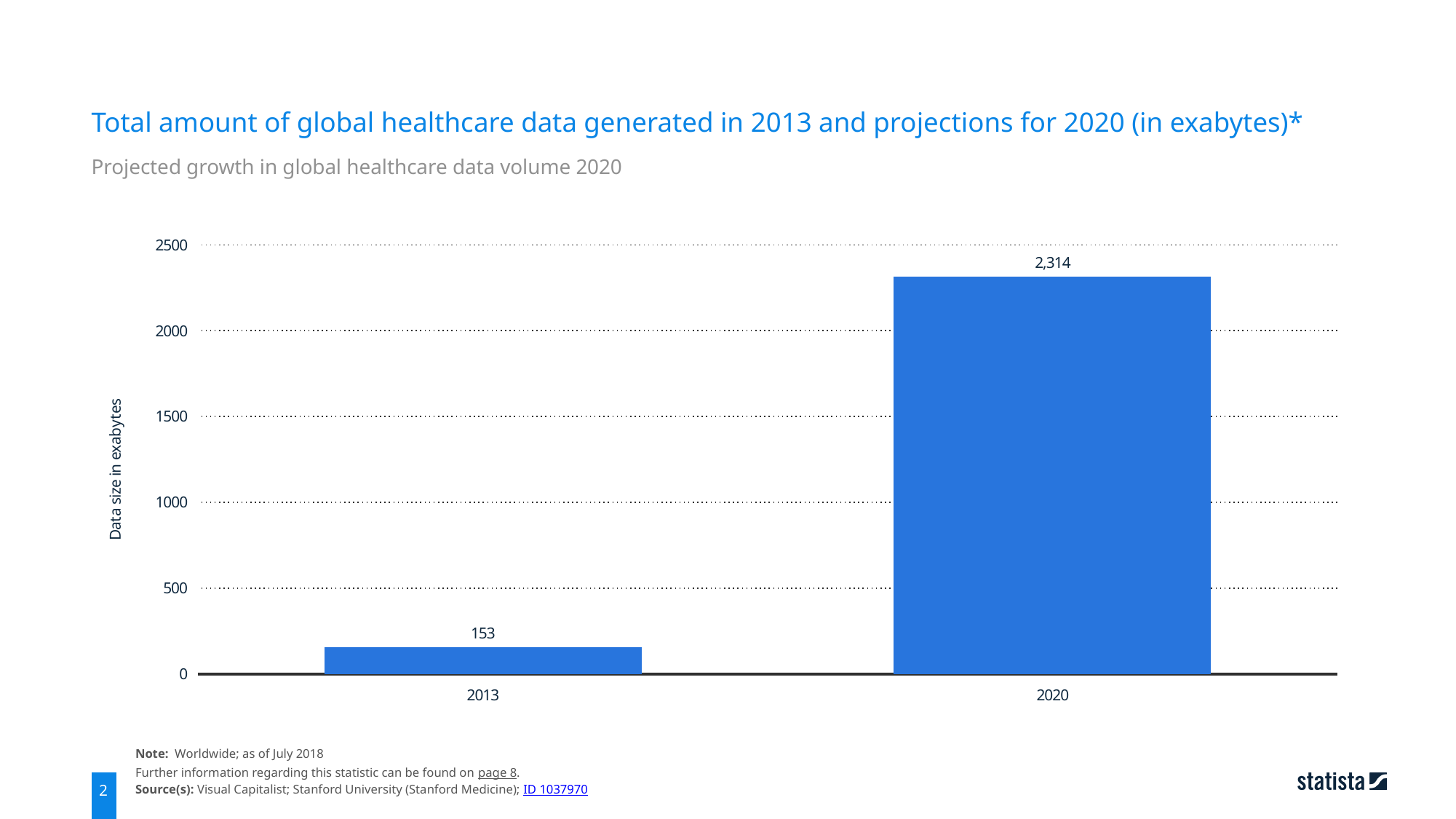
How many years are shown on the chart? 2 What is the projected value for 2020? 2,314 What is the value for 2013? 153 Do the values rise or fall from 2013 to 2020? rise Is the value for 2020 greater or less than 2000? greater Which year has the highest value? 2020 What kind of chart is shown on the slide? bar chart Which year has the lowest value? 2013 What is the difference between the 2020 and 2013 values? 2,161 Is the value for 2013 greater or less than 500? less What is the label of the y axis? Data size in exabytes Which is larger, the value for 2013 or the value for 2020? 2020